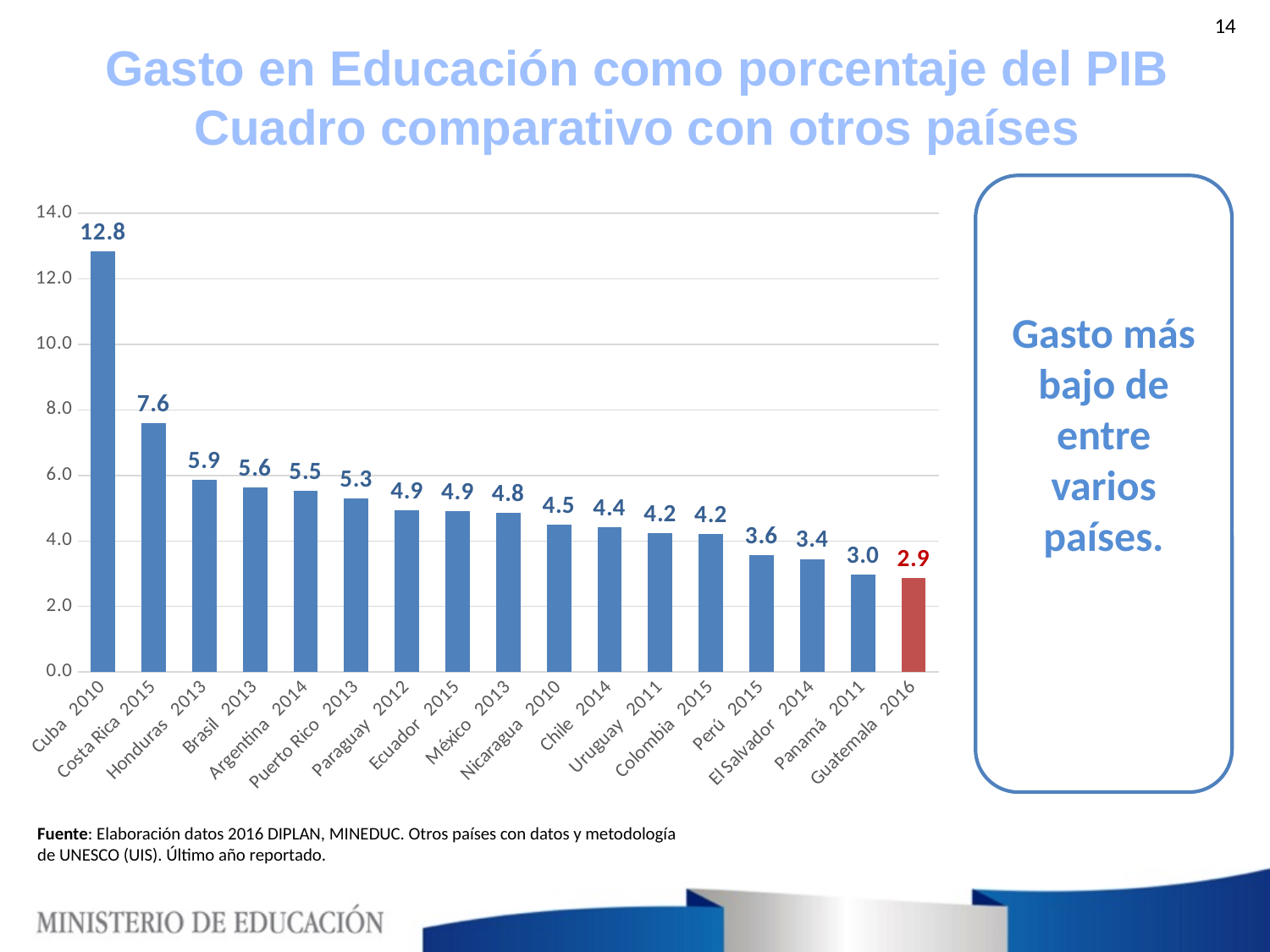
Which bar is shown in a different colour (red) from the others? Guatemala 2016 Which is larger, the value for Perú 2015 or the value for Panamá 2011? Perú 2015 Which country has the highest value in the chart? Cuba 2010 What is the value shown for Guatemala 2016? 2.9 How many countries are shown in the chart? 17 What kind of chart is shown on the slide? Bar chart What is the difference between the values for Costa Rica 2015 and Honduras 2013? 1.7 What is the value shown for Cuba 2010? 12.8 What is the value shown for Chile 2014? 4.4 What is the difference between the values for Cuba 2010 and Guatemala 2016? 9.9 Which country has the lowest value in the chart? Guatemala 2016 What is the value shown for Costa Rica 2015? 7.6